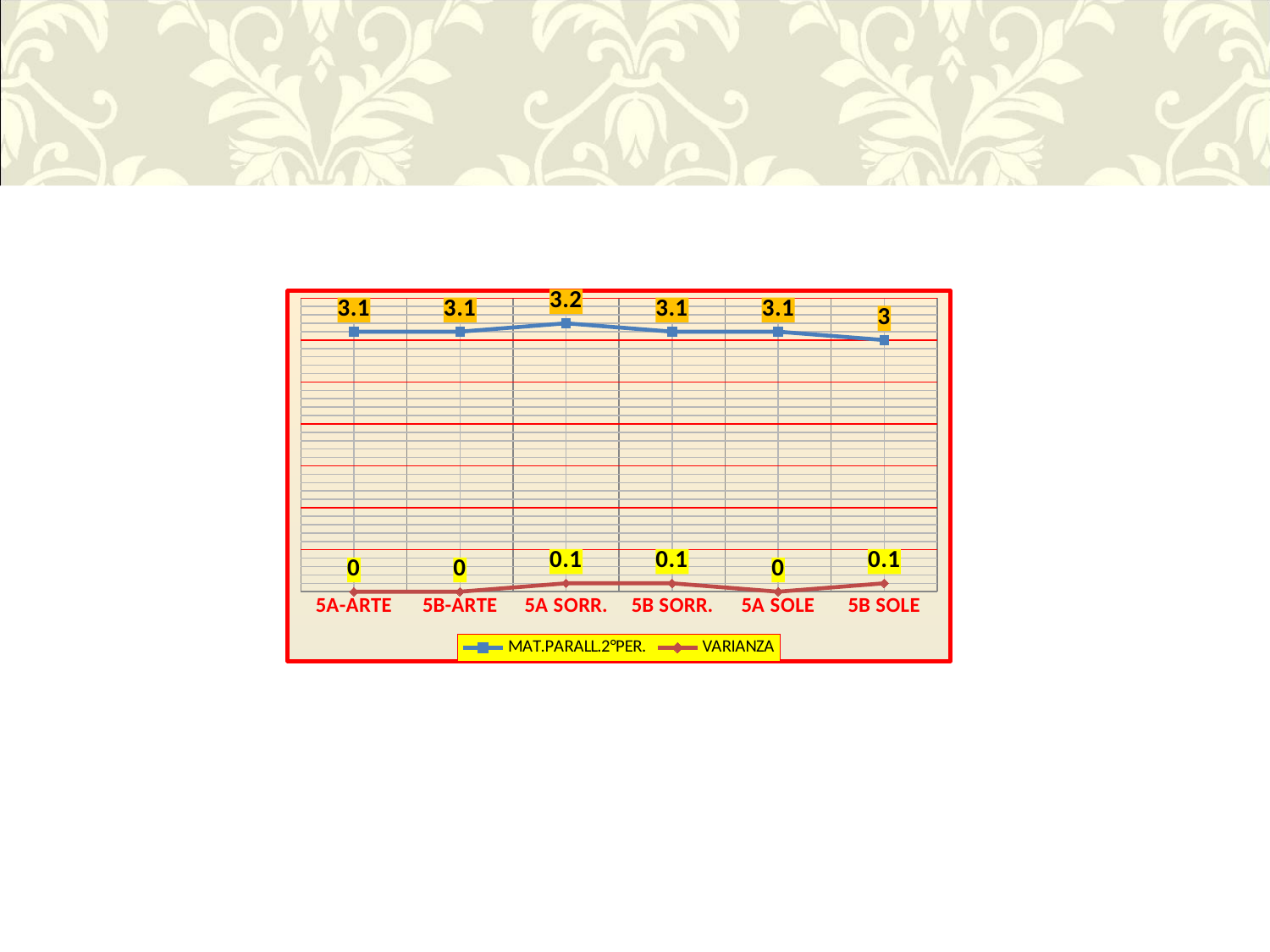
What is the VARIANZA value for 5A SOLE? 0 Which category has the lowest MAT.PARALL.2°PER. value? 5B SOLE What is the difference between the MAT.PARALL.2°PER. values for 5A SORR. and 5B SOLE? 0.2 How many series does the legend list? 2 What is the VARIANZA value for 5B SORR.? 0.1 What kind of chart is shown on the slide? line chart Which is larger, the MAT.PARALL.2°PER. value for 5A-ARTE or for 5B SOLE? 5A-ARTE Which category has the highest MAT.PARALL.2°PER. value? 5A SORR. What is the MAT.PARALL.2°PER. value for 5B SOLE? 3 What is the MAT.PARALL.2°PER. value for 5A SORR.? 3.2 What are the two series names listed in the legend? MAT.PARALL.2°PER. and VARIANZA How many categories are shown on the x axis? 6